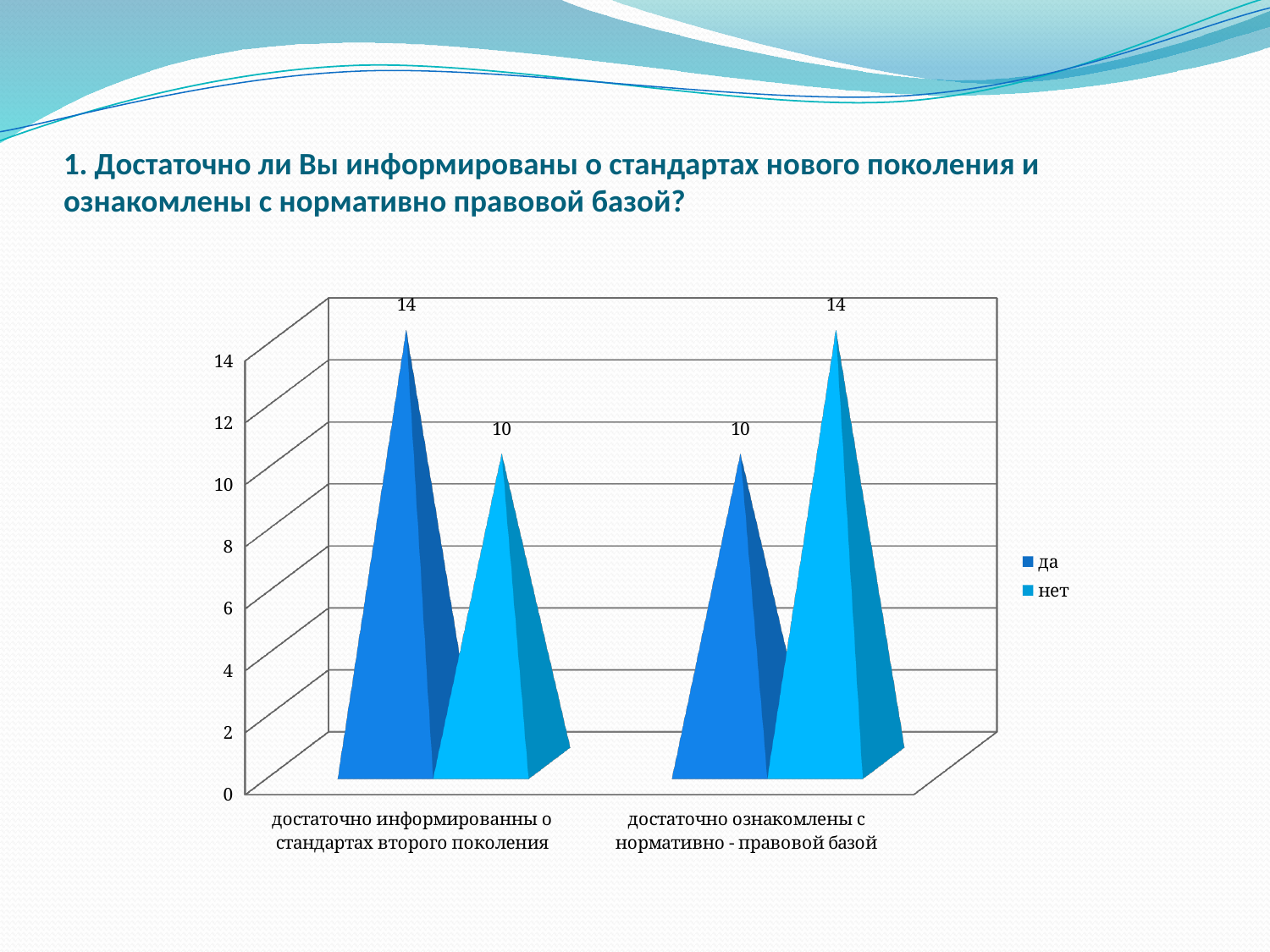
What is the value for "да" in the category "достаточно ознакомлены с нормативно - правовой базой"? 10 In the category "достаточно информированны о стандартах второго поколения", which series is larger, "да" or "нет"? да What is the value for "да" in the category "достаточно информированны о стандартах второго поколения"? 14 How many series does the legend list? 2 What is the difference between the "нет" and "да" values in the category "достаточно ознакомлены с нормативно - правовой базой"? 4 What are the two entries in the chart's legend? да, нет In the category "достаточно ознакомлены с нормативно - правовой базой", which series is larger, "да" or "нет"? нет What kind of chart is shown on the slide? bar chart How many categories are shown on the x axis of the chart? 2 What is the value for "нет" in the category "достаточно информированны о стандартах второго поколения"? 10 What is the difference between the "да" and "нет" values in the category "достаточно информированны о стандартах второго поколения"? 4 What is the value for "нет" in the category "достаточно ознакомлены с нормативно - правовой базой"? 14